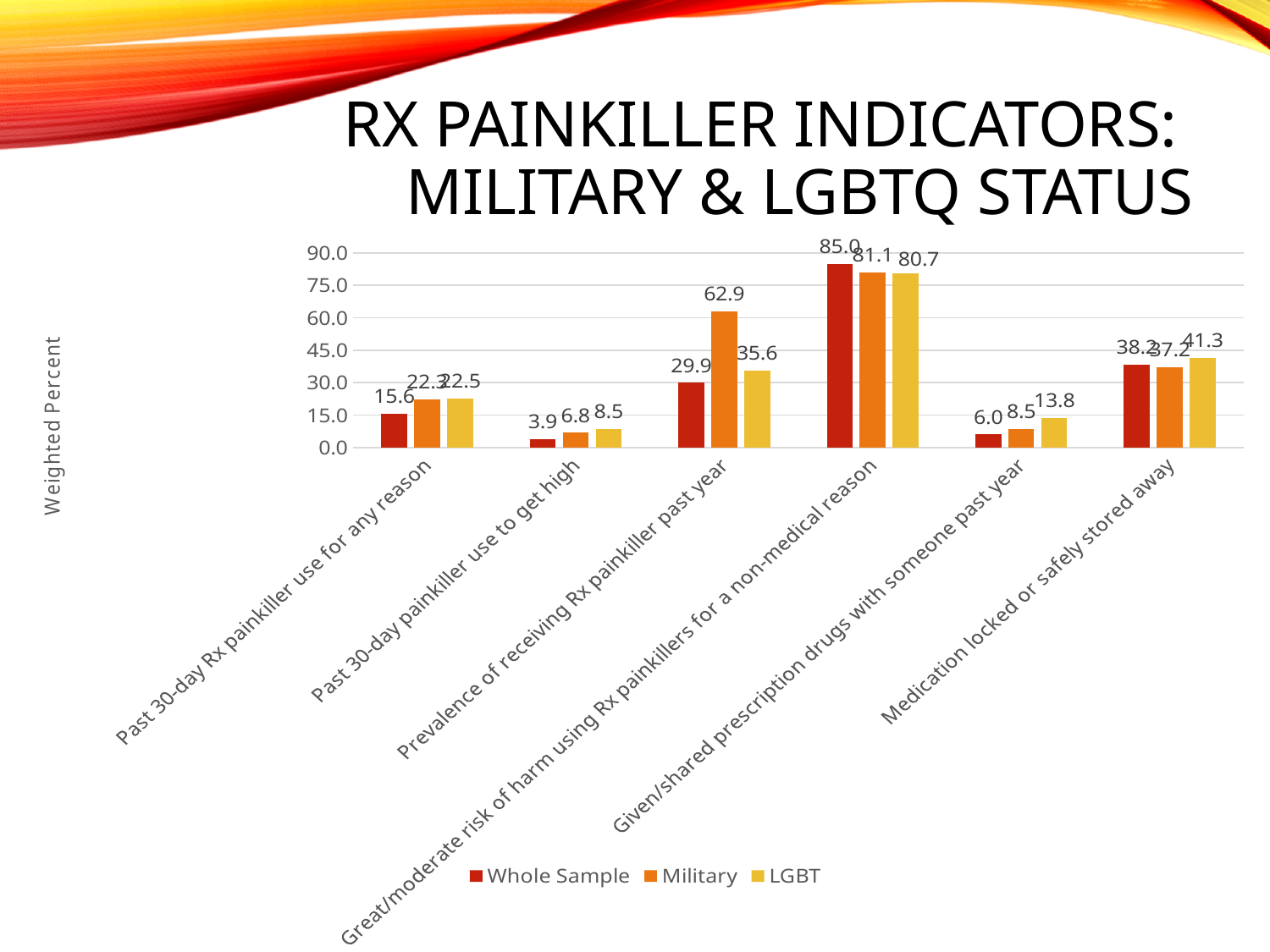
Is the LGBT value for Medication locked or safely stored away greater or less than 30.0? greater What is the Whole Sample value for Great/moderate risk of harm using Rx painkillers for a non-medical reason? 85.0 What is the Whole Sample value for Past 30-day painkiller use to get high? 3.9 For Given/shared prescription drugs with someone past year, which is larger: the LGBT value or the Military value? LGBT What is the Military value for Prevalence of receiving Rx painkiller past year? 62.9 Which category has the highest Whole Sample value? Great/moderate risk of harm using Rx painkillers for a non-medical reason How many categories are shown on the x axis? 6 What type of chart is shown on the slide? Bar chart What is the LGBT value for Given/shared prescription drugs with someone past year? 13.8 How many series does the legend list? 3 What is the difference between the Military and Whole Sample values for Prevalence of receiving Rx painkiller past year? 33.0 Which category has the lowest Military value? Past 30-day painkiller use to get high